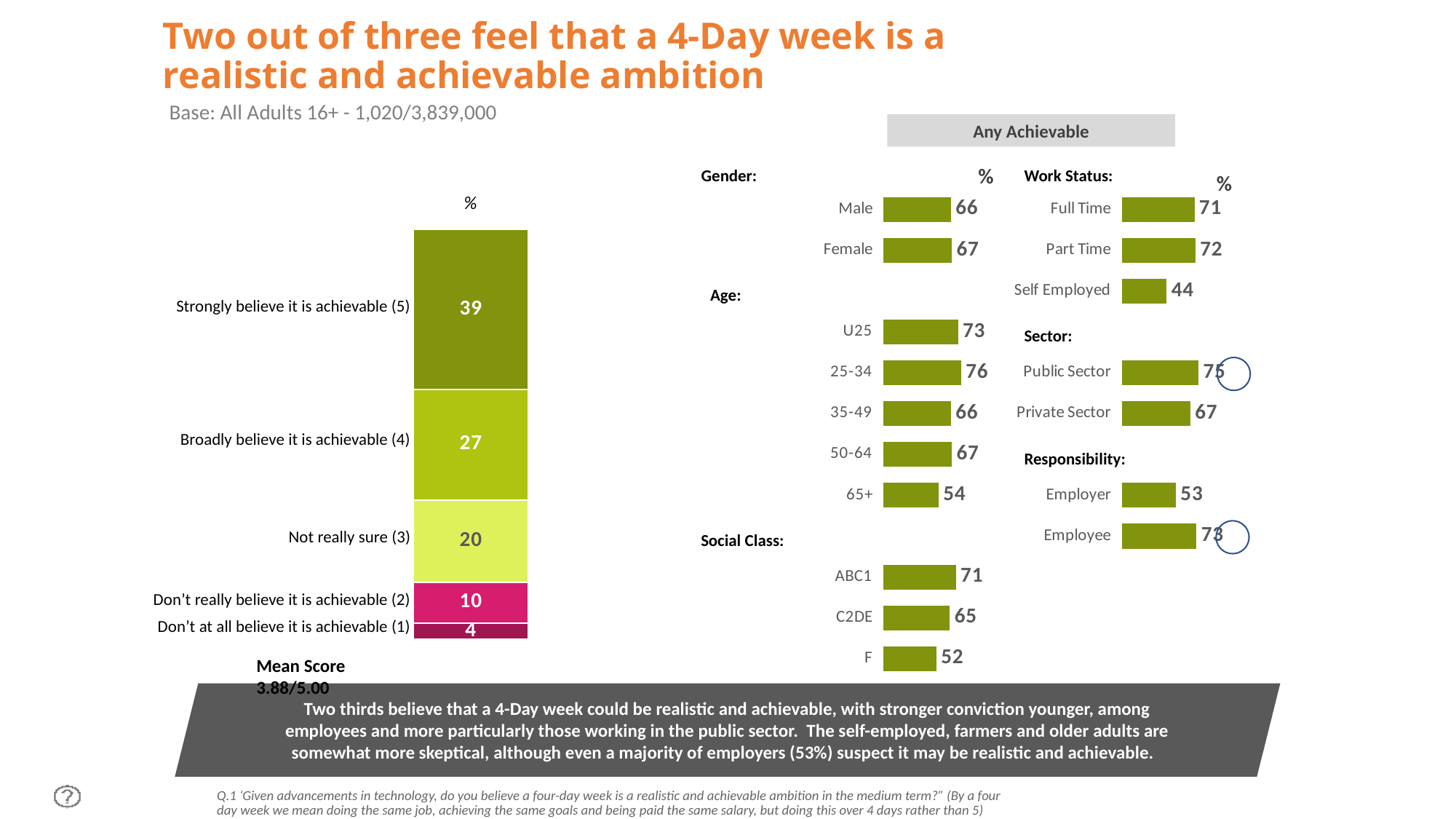
In the stacked bar chart on the left, what percentage strongly believe a 4-Day week is achievable (5)? 39 What kind of chart is shown on the left of the slide? Stacked bar chart In the 'Any Achievable' chart on the right, which is larger, the value for U25 or the value for 65+? U25 In the 'Any Achievable' chart on the right, what is the value for Self Employed? 44 In the stacked bar chart on the left, what is the difference between 'Strongly believe it is achievable (5)' and 'Broadly believe it is achievable (4)'? 12 In the 'Any Achievable' chart on the right, what is the difference between Full Time and Self Employed? 27 In the 'Any Achievable' chart on the right, which social class has the lowest value? F In the stacked bar chart on the left, what is the total of all five segments? 100 How many age groups are shown in the 'Any Achievable' chart on the right? 5 In the stacked bar chart on the left, which response category has the smallest value? Don't at all believe it is achievable (1) In the 'Any Achievable' chart on the right, which age group has the highest value? 25-34 In the stacked bar chart on the left, what is the value for 'Not really sure (3)'? 20